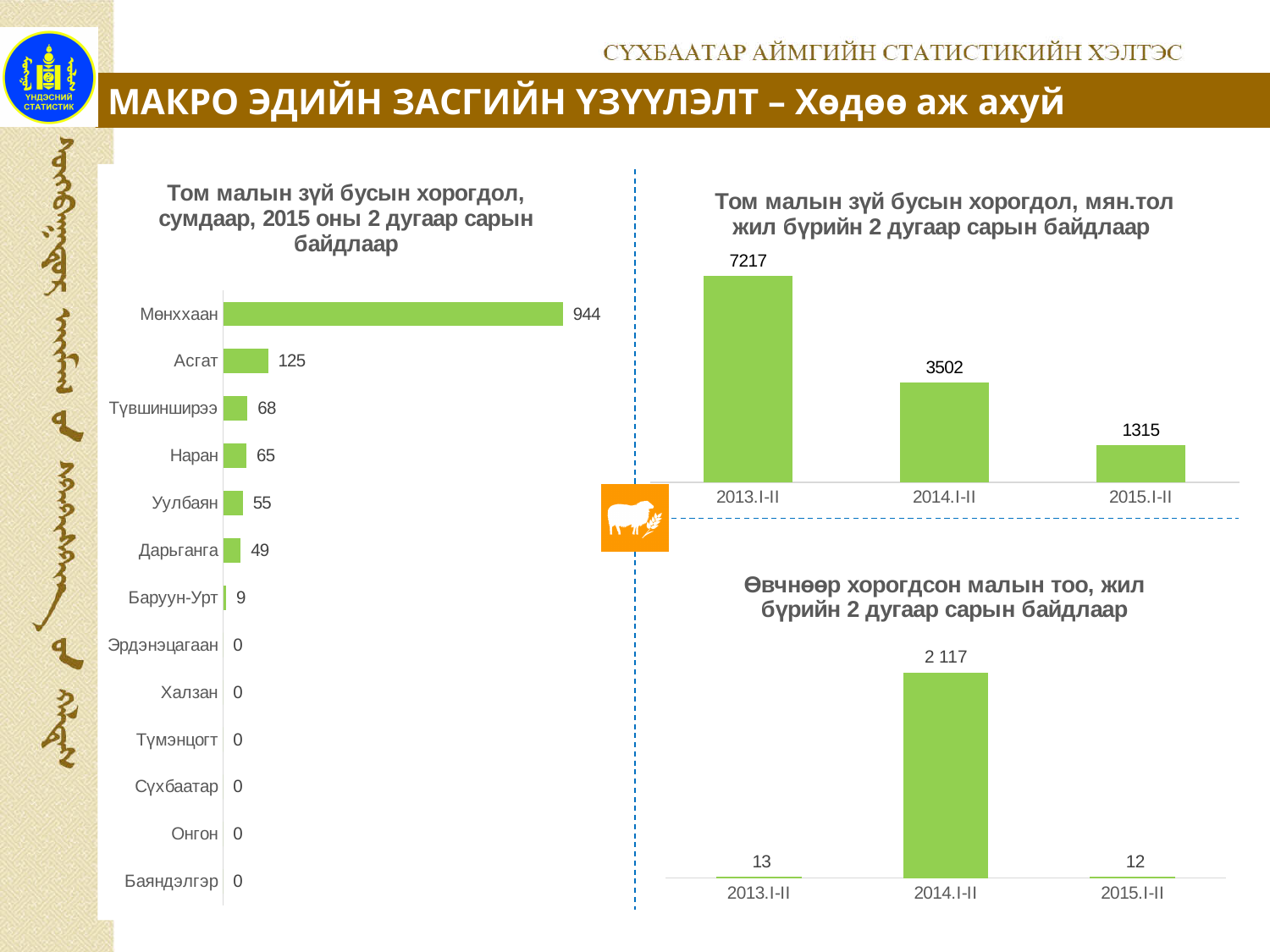
In the left chart (Том малын зүй бусын хорогдол, сумдаар), how many categories are shown? 13 In the bottom right chart (Өвчнөөр хорогдсон малын тоо), which period has the lowest value? 2015.I-II In the top right chart (Том малын зүй бусын хорогдол, мян.тол), what is the value for 2014.I-II? 3502 What kind of chart is the left chart (Том малын зүй бусын хорогдол, сумдаар)? bar chart In the bottom right chart (Өвчнөөр хорогдсон малын тоо), what is the value for 2014.I-II? 2 117 In the top right chart (Том малын зүй бусын хорогдол, мян.тол), what is the difference between 2013.I-II and 2015.I-II? 5902 In the left chart (Том малын зүй бусын хорогдол, сумдаар), what is the value for Асгат? 125 In the left chart (Том малын зүй бусын хорогдол, сумдаар), what is the value for Мөнххаан? 944 In the top right chart (Том малын зүй бусын хорогдол, мян.тол), do the values rise or fall from 2013.I-II to 2015.I-II? fall In the left chart (Том малын зүй бусын хорогдол, сумдаар), which is larger, Уулбаян or Дарьганга? Уулбаян In the left chart (Том малын зүй бусын хорогдол, сумдаар), what is the difference between Түвшинширээ and Наран? 3 In the left chart (Том малын зүй бусын хорогдол, сумдаар), which category has the highest value? Мөнххаан